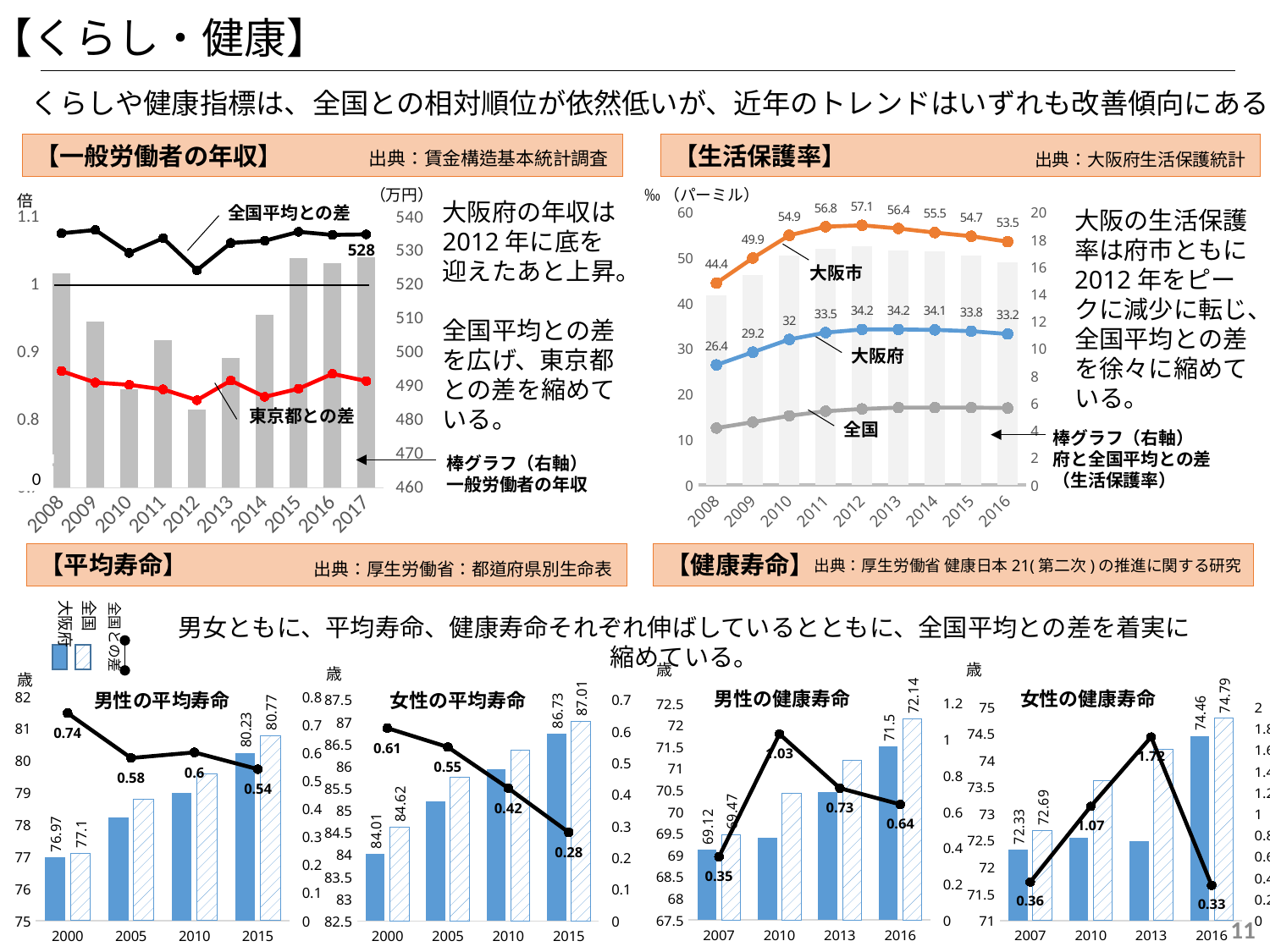
In the 男性の平均寿命 chart, what is the value for 大阪府 in 2015? 80.23 In the 一般労働者の年収 chart, in which year is the 全国平均との差 line at its lowest? 2012 In the 生活保護率 chart, in which year does the 大阪市 line reach its highest value? 2012 In the 生活保護率 chart, what is the difference between the 大阪市 and 大阪府 values in 2016? 20.3 In the 生活保護率 chart, how many years are shown on the x axis? 9 In the 生活保護率 chart, what is the value for 大阪府 in 2008? 26.4 In the 女性の健康寿命 chart, what is the difference between the 全国 and 大阪府 bars in 2016? 0.33 In the 生活保護率 chart, is the value for 全国 in 2016 greater or less than 20? less In the 生活保護率 chart, what is the value for 大阪市 in 2012? 57.1 In the 一般労働者の年収 chart, what is the bar value for 2017? 528 In the 女性の平均寿命 chart, does the 全国との差 line rise or fall from 2000 to 2015? fall In the 男性の健康寿命 chart, in which year is the 全国との差 line highest? 2010